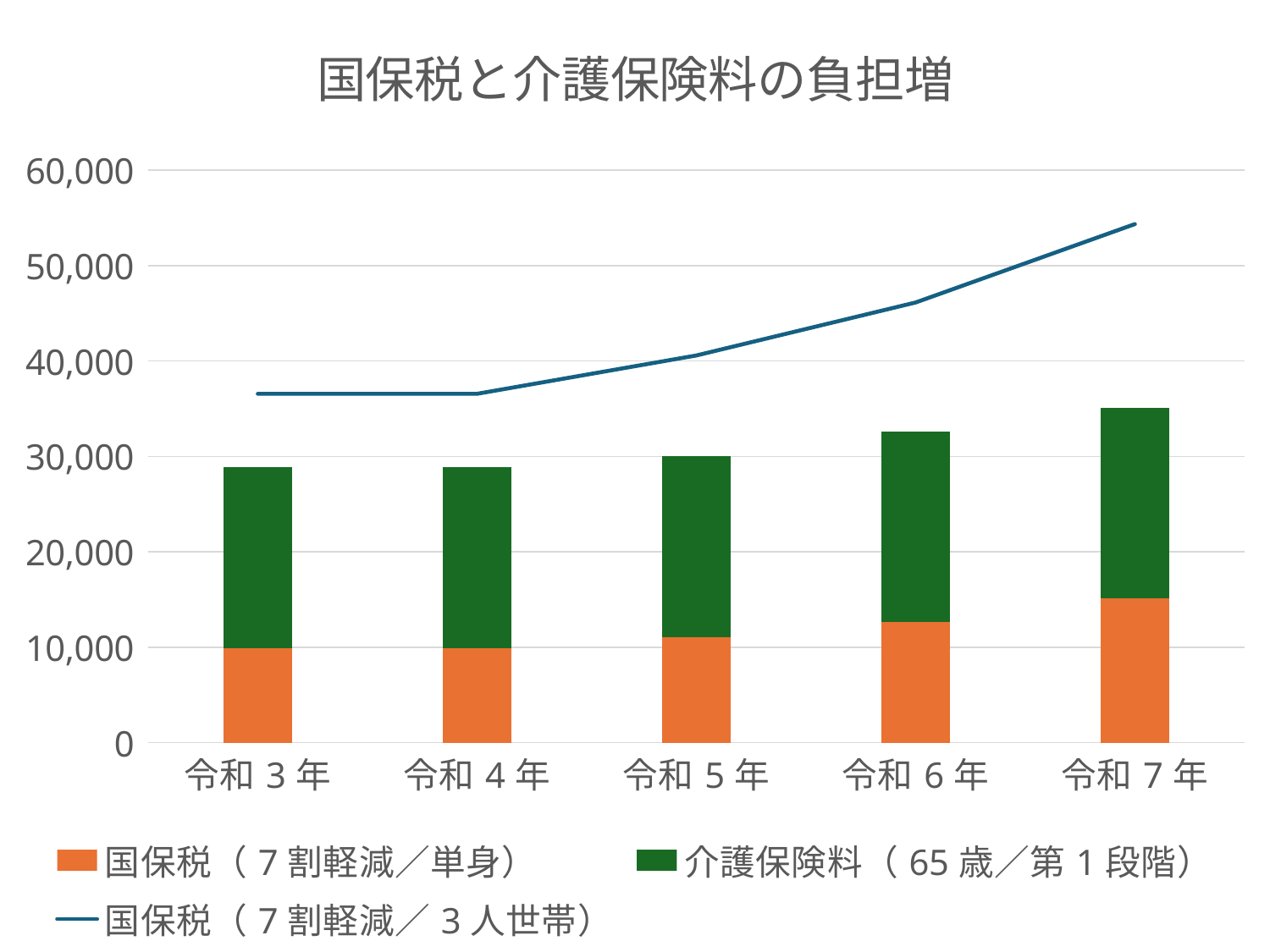
What is the title of the chart? 国保税と介護保険料の負担増 In which year does the 国保税（７割軽減／３人世帯） line reach its highest value? 令和７年 Is the 国保税（７割軽減／単身） value for 令和７年 greater or less than 10,000? greater How many categories are shown on the x axis? 5 Is the total height of the stacked bar for 令和７年 greater or less than 30,000? greater Which series is drawn as a line rather than bars? 国保税（７割軽減／３人世帯） How many series does the legend list? 3 Is the value of the 国保税（７割軽減／３人世帯） line for 令和７年 greater or less than 50,000? greater Which year has the tallest stacked bar? 令和７年 What kind of chart is shown on the slide? A stacked bar chart combined with a line chart Does the 国保税（７割軽減／３人世帯） line rise or fall from 令和３年 to 令和７年? rise